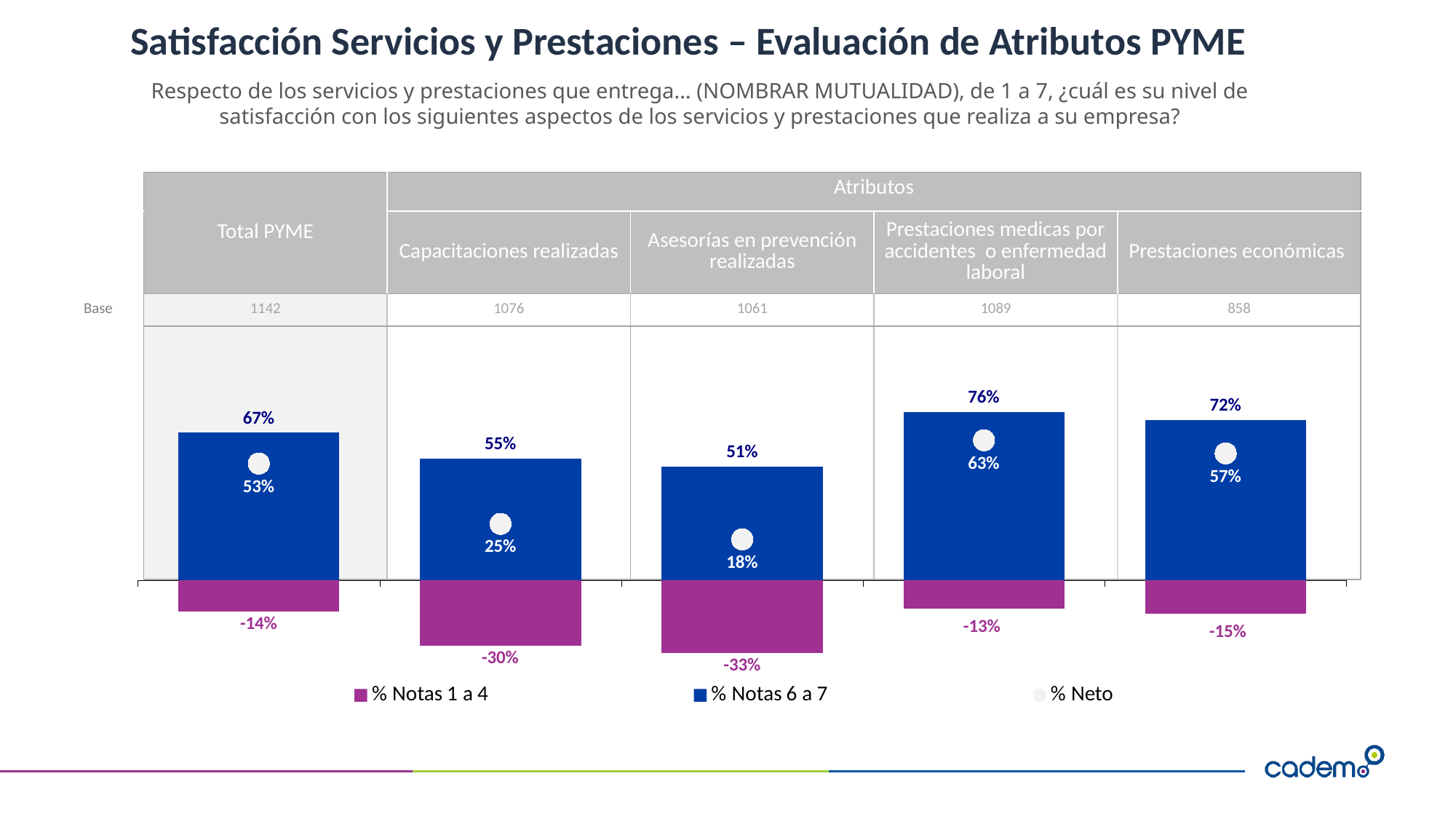
What is the difference between the % Notas 6 a 7 values for Prestaciones económicas and Capacitaciones realizadas? 17 percentage points What is the % Notas 6 a 7 value for Total PYME? 67% What is the % Neto value for Prestaciones económicas? 57% Which category has the highest % Notas 6 a 7 value? Prestaciones medicas por accidentes o enfermedad laboral How many series does the legend list? 3 What is the base (sample size) shown for Prestaciones económicas? 858 Which category has the lowest % Neto value? Asesorías en prevención realizadas What is the % Notas 1 a 4 value for Asesorías en prevención realizadas? -33% Which is larger, the % Neto for Total PYME or for Prestaciones económicas? Prestaciones económicas How many categories are shown on the x axis? 5 What kind of chart is this? Combination bar and line chart (bars with dot markers for % Neto) Which colour represents the % Notas 1 a 4 series? Purple